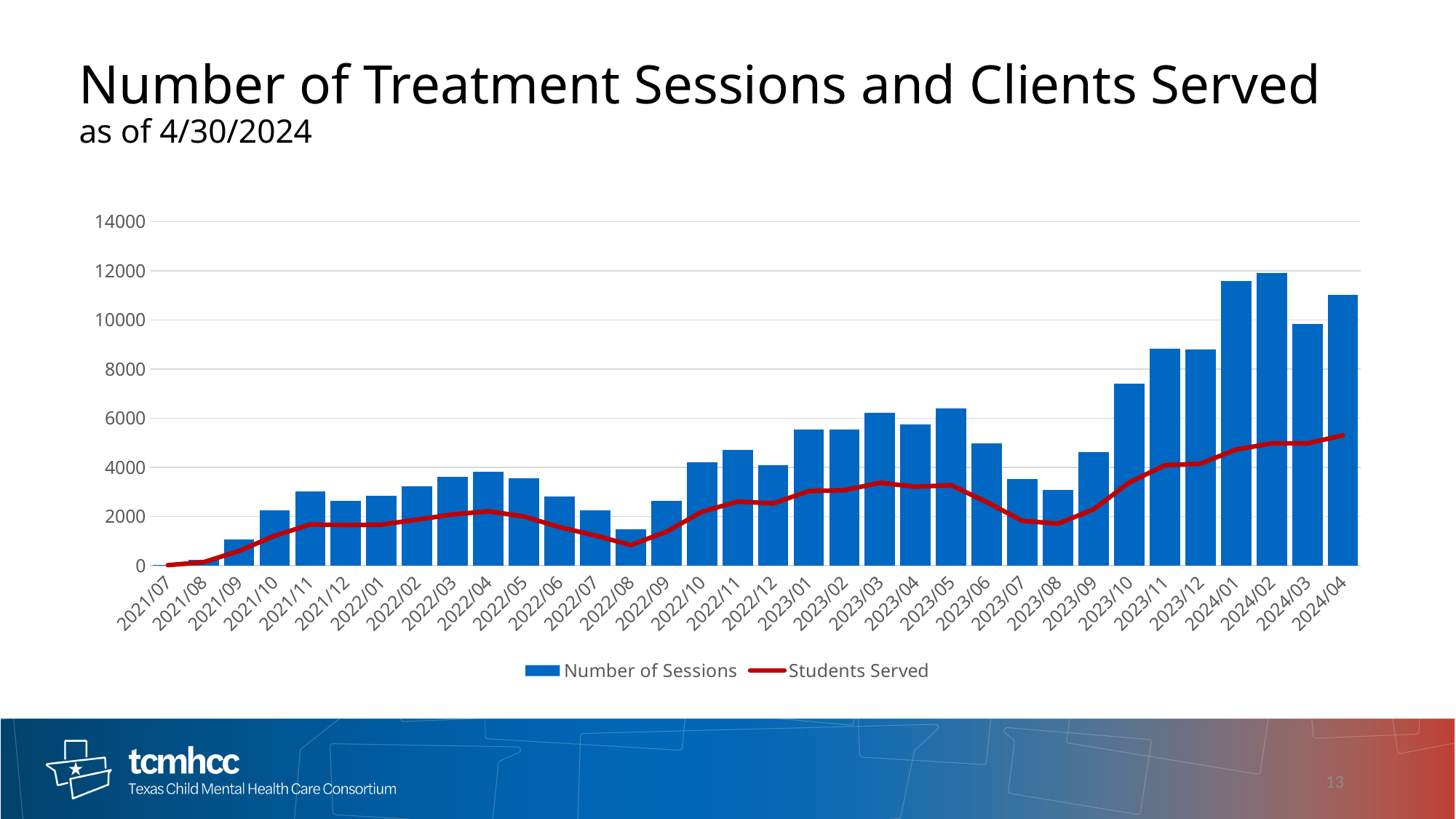
Which month has the highest Number of Sessions bar? 2024/02 Which month has the larger Number of Sessions, 2024/03 or 2024/04? 2024/04 What kind of chart is shown on the slide? A combined bar and line chart Overall, do the Number of Sessions bars rise or fall from 2021/07 to 2024/04? rise Is the Number of Sessions for 2024/04 greater or less than 10000? greater Which month has the lowest Number of Sessions bar? 2021/07 How many months are shown along the x axis? 34 Which series is drawn as a red line? Students Served Is the Number of Sessions for 2022/08 greater or less than 2000? less Is the Number of Sessions for 2023/10 greater or less than 6000? greater How many series does the legend list? 2